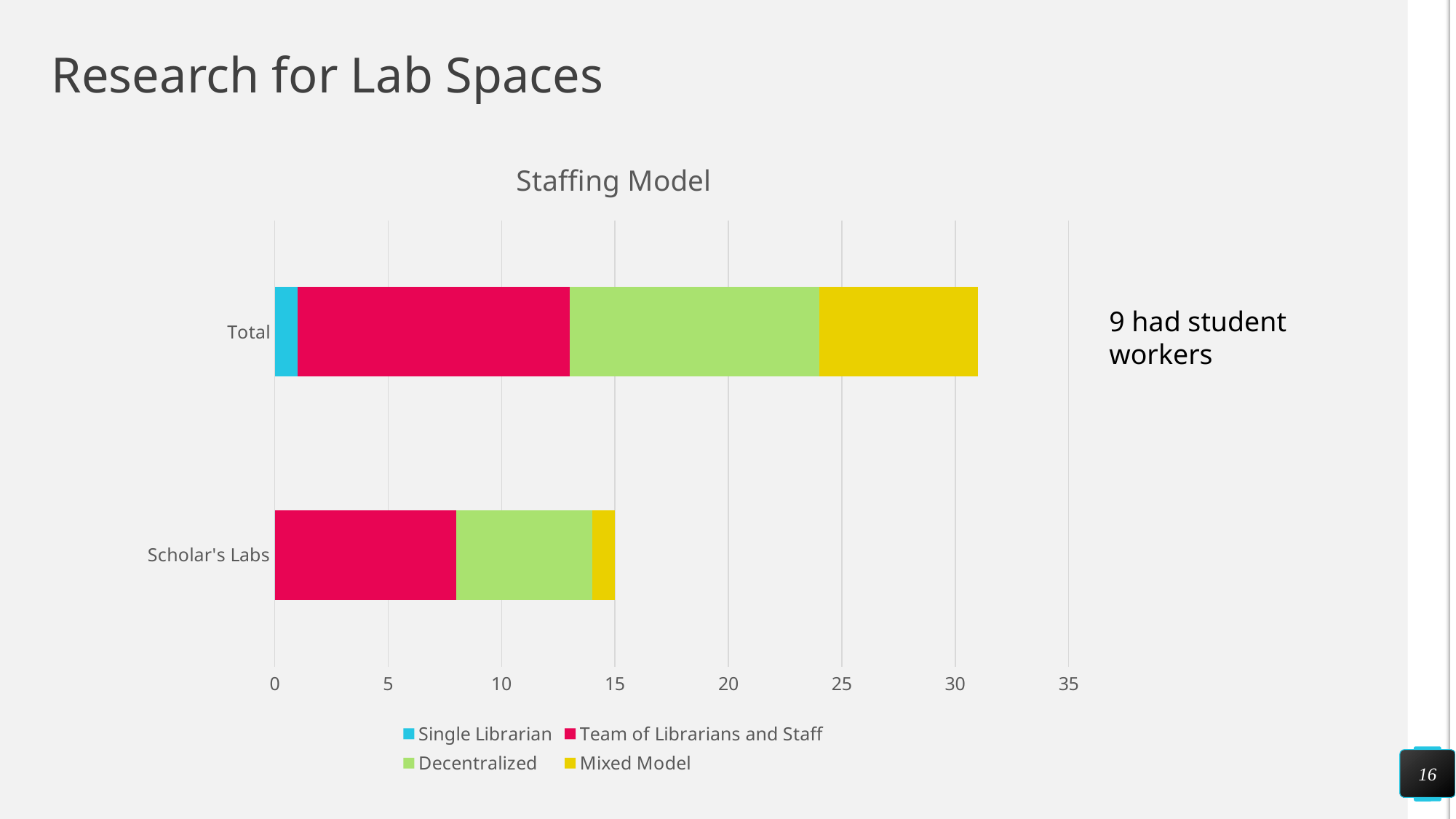
Which category has the longer stacked bar, Total or Scholar's Labs? Total How many categories are plotted on the y axis of the Staffing Model chart? 2 What is the title of the chart on the slide? Staffing Model In the Scholar's Labs bar, which segment is larger: Team of Librarians and Staff or Decentralized? Team of Librarians and Staff What kind of chart is shown under the title "Staffing Model"? Stacked bar chart Is the total length of the Scholar's Labs bar greater or less than 20? less Which colour represents the Mixed Model series in the Staffing Model chart? Yellow What is the total of the stacked bar for Scholar's Labs? 15 In the Total bar, which series has the smallest segment? Single Librarian How many series does the legend of the Staffing Model chart list? 4 Is the total length of the Total bar greater or less than 25? greater In the Scholar's Labs bar, which series has the largest segment? Team of Librarians and Staff